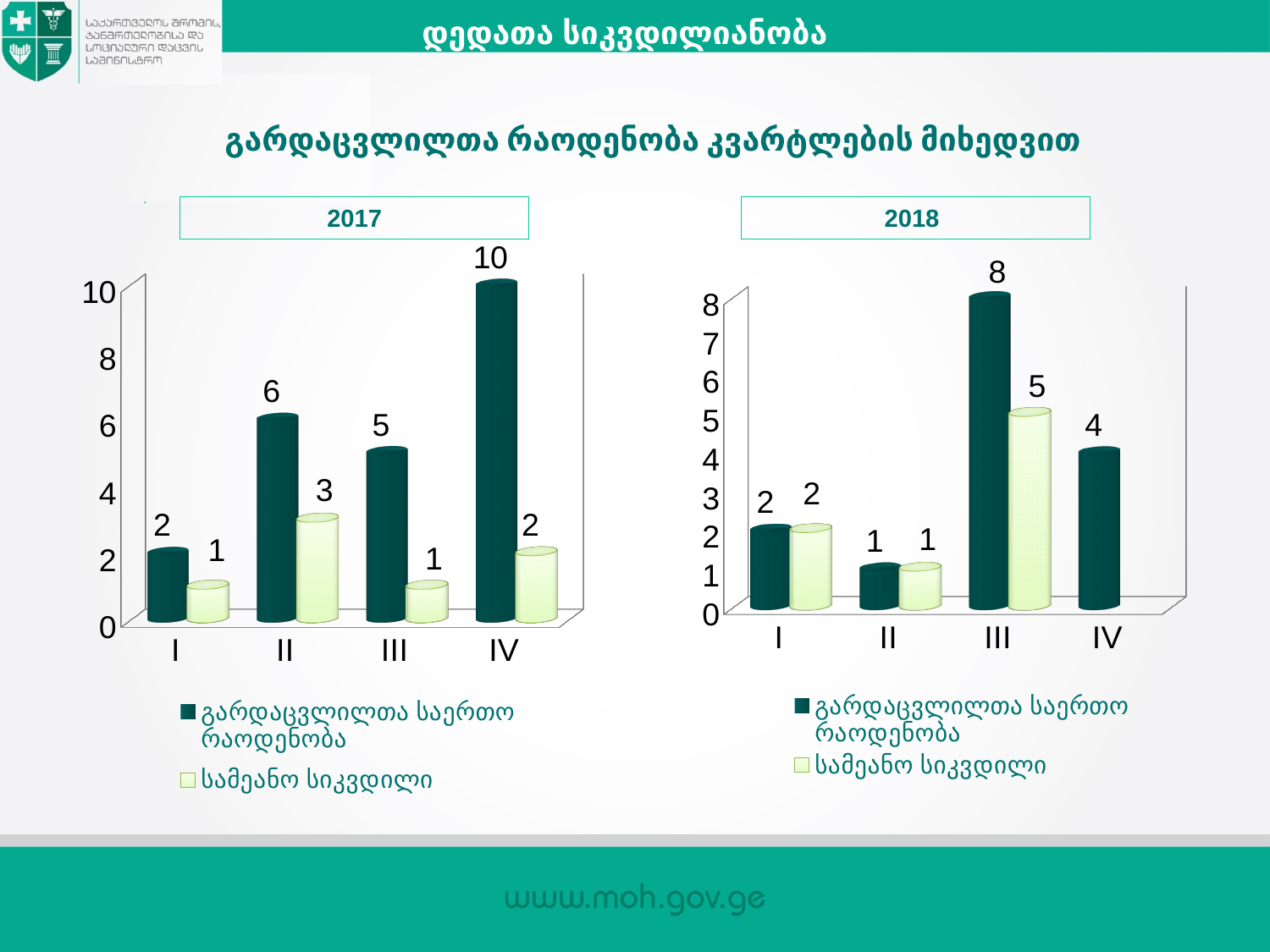
In the 2017 chart, what is the value of the light green series (სამეანო სიკვდილი) for quarter II? 3 In the 2018 chart, what is the value of the dark green series for quarter IV? 4 In the 2018 chart, is the dark green value for quarter III greater or less than 6? greater In the 2017 chart, what is the difference between the dark green and light green values for quarter III? 4 How many series does the legend of the 2018 chart list? 2 In the 2017 chart, which is larger: the dark green value for quarter II or for quarter III? quarter II In the 2017 chart, which quarter has the highest value for the dark green series? IV What type of chart is the 2017 chart? bar chart In the 2018 chart, which quarter has the lowest value for the dark green series? II How many quarters (categories) are shown on the x axis of the 2017 chart? 4 In the 2017 chart, what is the value of the dark green series (გარდაცვლილთა საერთო რაოდენობა) for quarter IV? 10 In the 2018 chart, what is the value of the light green series (სამეანო სიკვდილი) for quarter III? 5